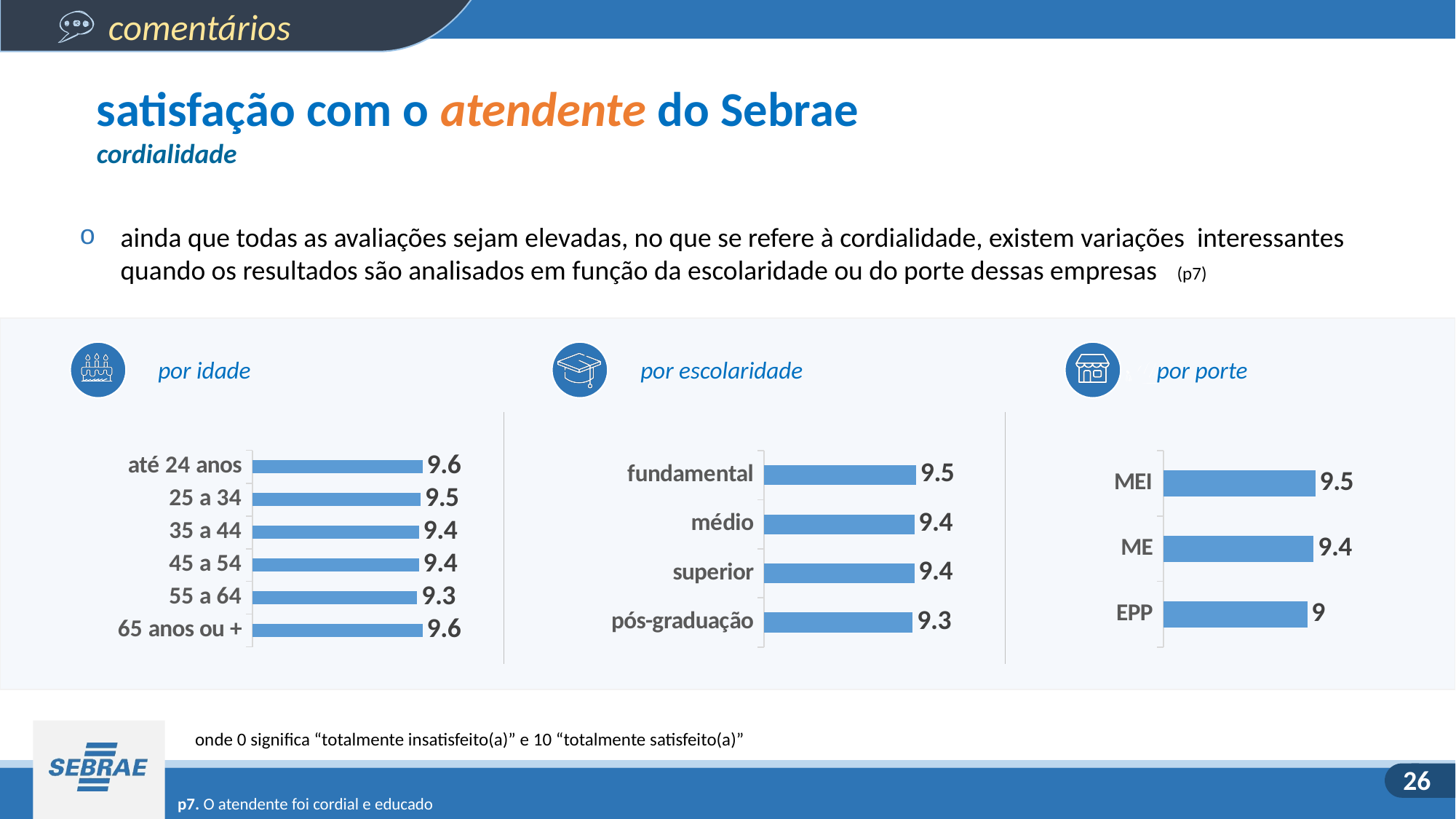
In the 'por idade' chart, what is the value for '25 a 34'? 9.5 In the 'por escolaridade' chart, which category has the highest value? fundamental In the 'por escolaridade' chart, do the values rise or fall from 'fundamental' to 'pós-graduação'? fall In the 'por porte' chart, what is the difference between the values for 'MEI' and 'EPP'? 0.5 In the 'por idade' chart, how many age categories are shown? 6 In the 'por porte' chart, what is the value for 'EPP'? 9 In the 'por idade' chart, what is the difference between the values for 'até 24 anos' and '55 a 64'? 0.3 What type of chart is the 'por porte' chart? bar chart In the 'por porte' chart, which category has the lowest value? EPP In the 'por idade' chart, which age group has the lowest value? 55 a 64 In the 'por escolaridade' chart, what is the value for 'pós-graduação'? 9.3 In the 'por porte' chart, which is larger, the value for 'MEI' or the value for 'ME'? MEI